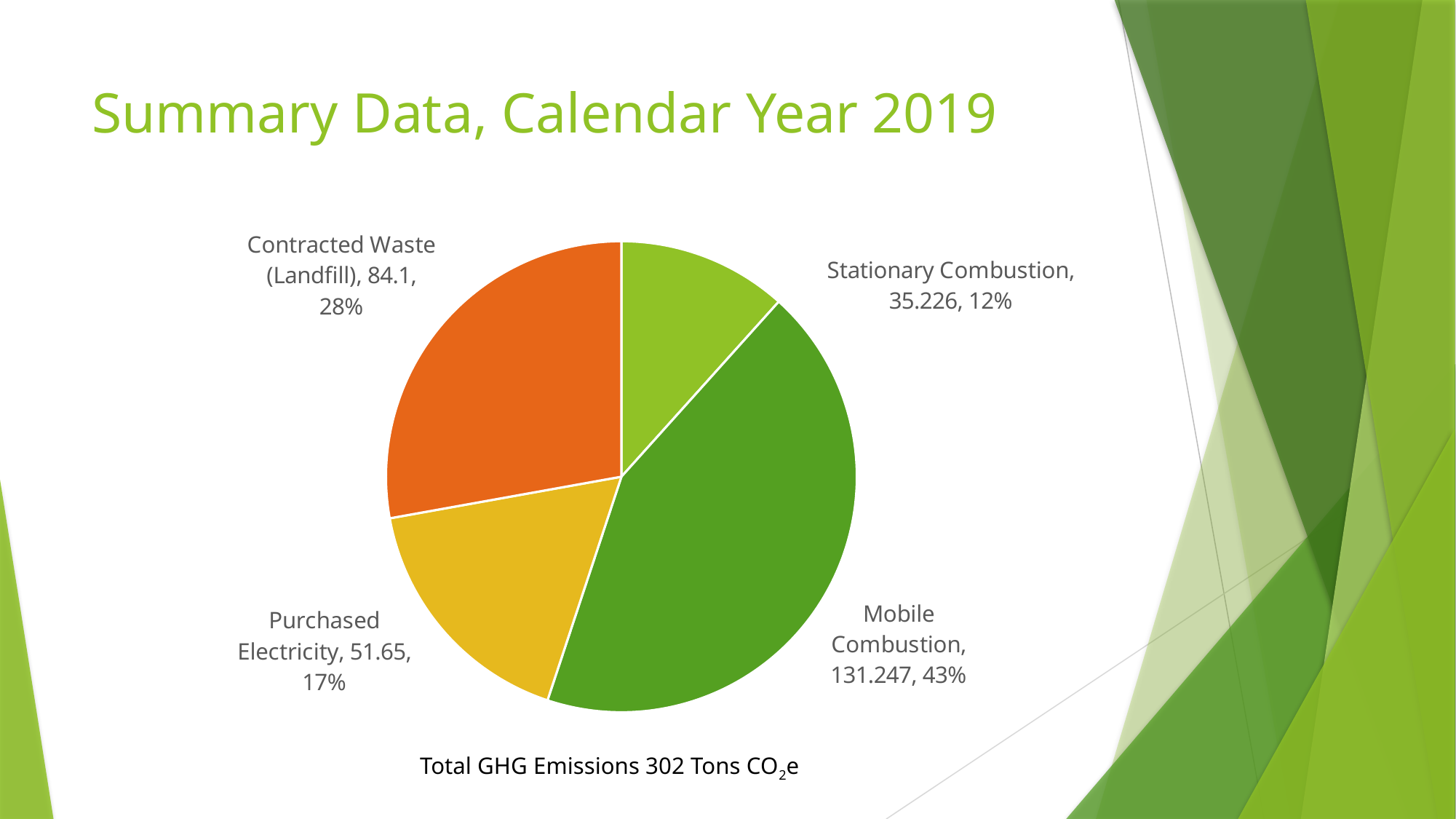
How many slices does the pie chart have? 4 What is the value for Stationary Combustion? 35.226 Which is larger, the value for Contracted Waste (Landfill) or the value for Purchased Electricity? Contracted Waste (Landfill) Which category has the smallest slice of the pie? Stationary Combustion What share of the pie does Purchased Electricity represent? 17% What total GHG emissions figure is stated below the pie chart? 302 Tons CO2e What is the value for Contracted Waste (Landfill)? 84.1 Which category has the largest slice of the pie? Mobile Combustion What is the value for Mobile Combustion? 131.247 What share of the pie does Contracted Waste (Landfill) represent? 28% What is the value for Purchased Electricity? 51.65 What type of chart is shown on the slide? pie chart